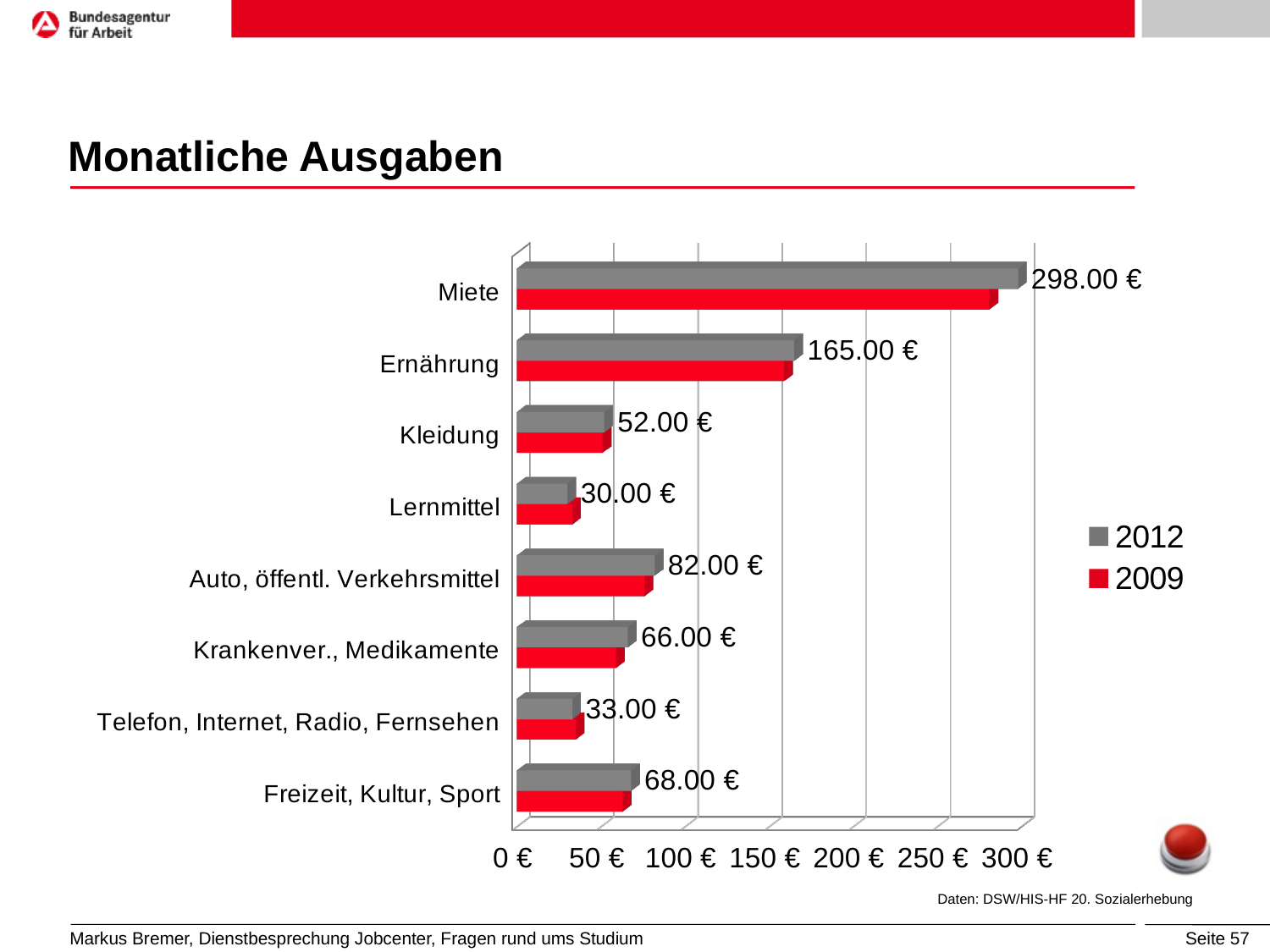
How many categories are shown on the chart? 8 Which category has the highest 2012 value? Miete What is the 2012 value for Ernährung? 165.00 € What type of chart is shown on the slide? Bar chart What is the 2012 value for Lernmittel? 30.00 € Which category has the lowest 2012 value? Lernmittel What is the 2012 value for Miete? 298.00 € Which has the larger 2012 value, Auto, öffentl. Verkehrsmittel or Krankenver., Medikamente? Auto, öffentl. Verkehrsmittel How many series does the legend list? 2 Is the 2009 value for Miete greater or less than 250 €? greater What is the difference between the 2012 values for Miete and Ernährung? 133.00 € What is the 2012 value for Freizeit, Kultur, Sport? 68.00 €